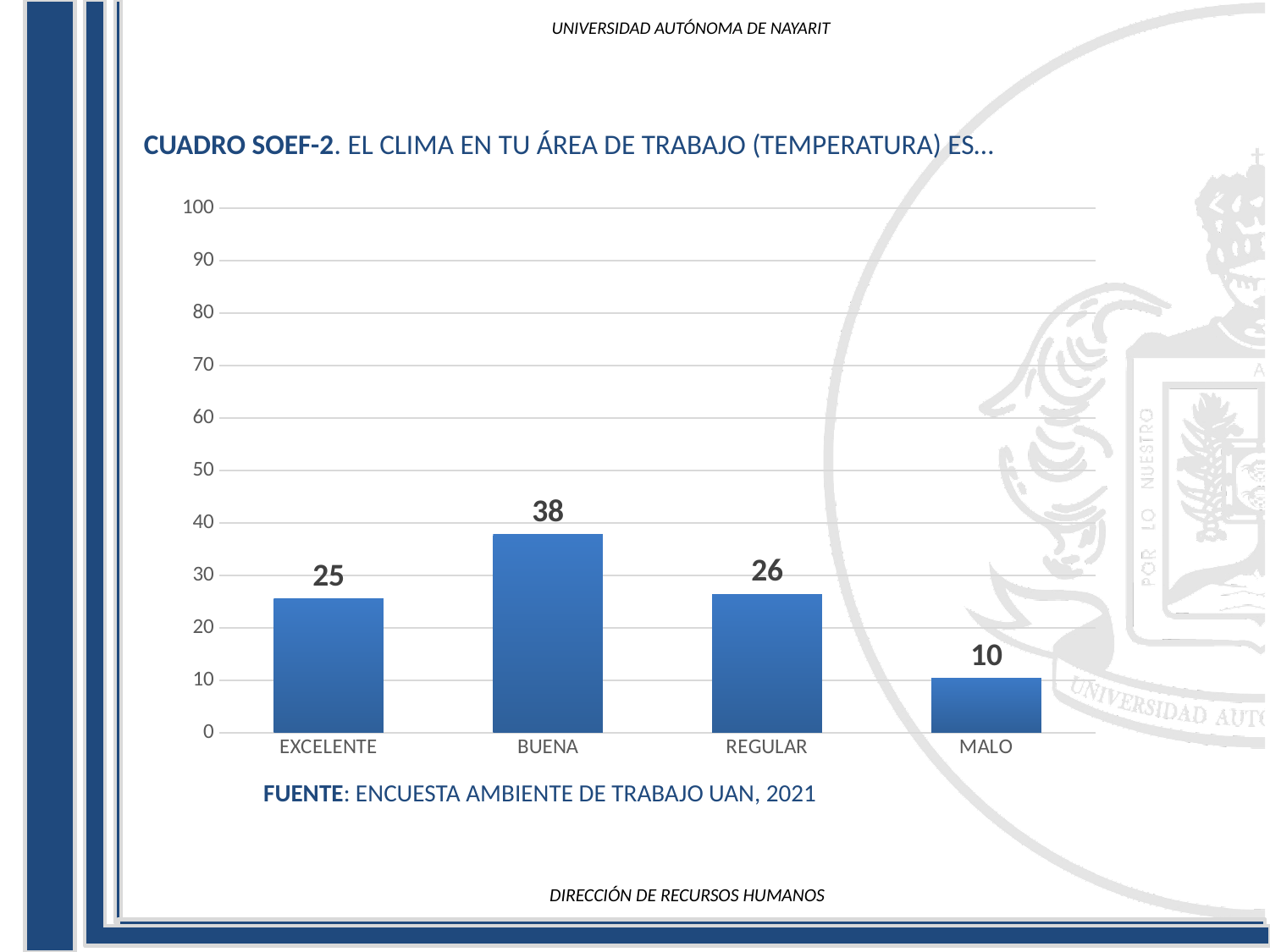
Is the value for REGULAR greater or less than 30? less What is the difference between the values for BUENA and MALO? 28 What is the value for MALO? 10 What source is cited below the chart? ENCUESTA AMBIENTE DE TRABAJO UAN, 2021 Which is larger, the value for BUENA or the value for REGULAR? BUENA How many categories are shown on the x axis? 4 What is the value for BUENA? 38 Which category has the lowest value? MALO What is the difference between the values for REGULAR and EXCELENTE? 1 What kind of chart is shown on the slide? bar chart Which category has the highest value? BUENA What is the value for EXCELENTE? 25